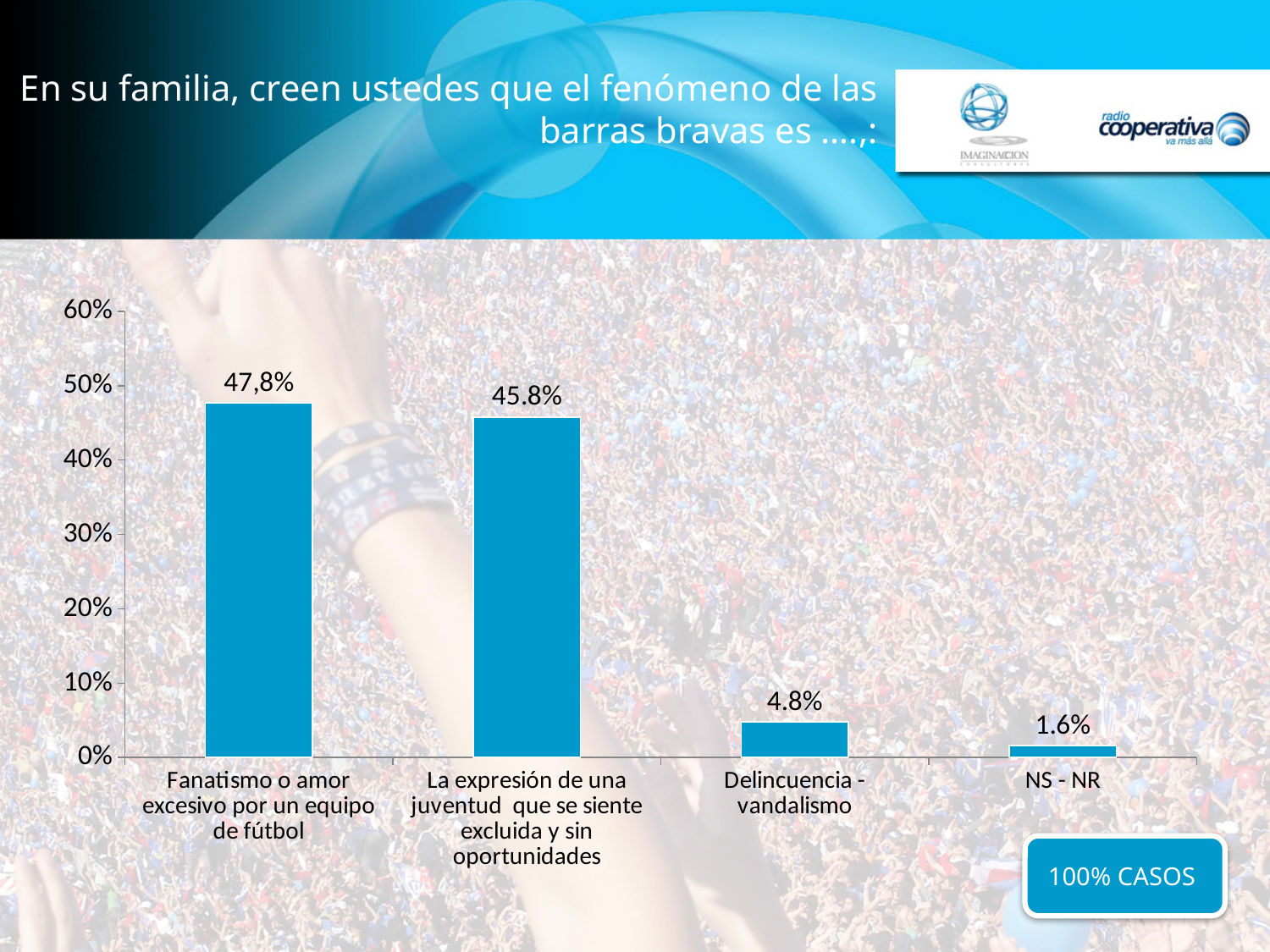
Is the value for "Delincuencia - vandalismo" greater or less than 10%? less What is the value shown for "NS - NR"? 1.6% What kind of chart is shown on the slide? bar chart What is the value shown for "Fanatismo o amor excesivo por un equipo de fútbol"? 47,8% Which is larger: the value for "Delincuencia - vandalismo" or the value for "NS - NR"? Delincuencia - vandalismo What is the value shown for "Delincuencia - vandalismo"? 4.8% How many categories are shown in the chart? 4 What is the value shown for "La expresión de una juventud que se siente excluida y sin oportunidades"? 45.8% What is the difference between the values for "Delincuencia - vandalismo" and "NS - NR"? 3.2% Which category has the highest value? Fanatismo o amor excesivo por un equipo de fútbol Which category has the lowest value? NS - NR Is the value for "Fanatismo o amor excesivo por un equipo de fútbol" greater or less than 40%? greater